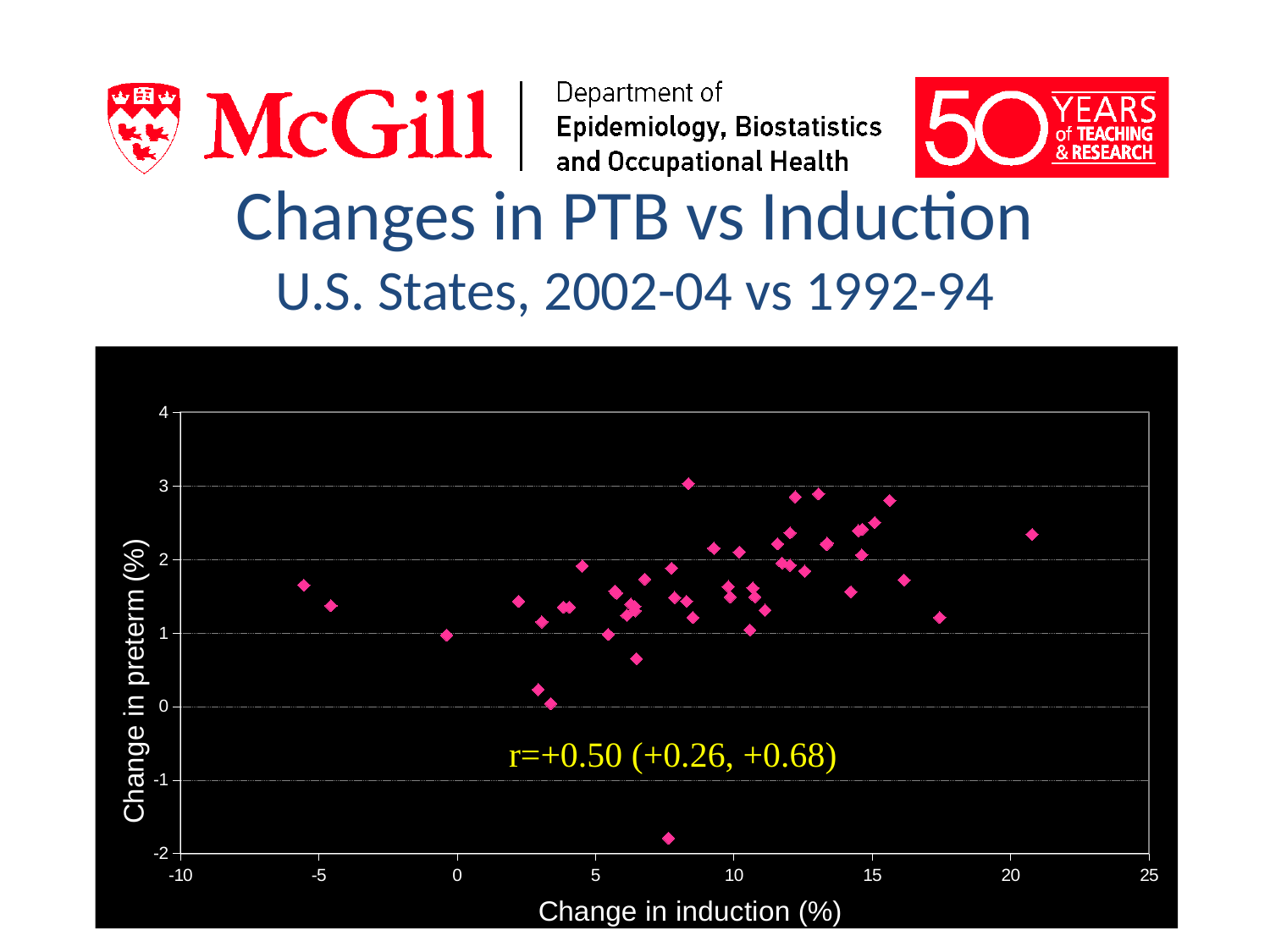
What is the highest tick value shown on the x axis? 25 What is the label of the x axis of the chart? Change in induction (%) What kind of chart is shown on the slide? Scatter plot Is the change in preterm for the lowest point on the chart greater or less than -1? less Is the change in induction for the rightmost point on the chart greater or less than 20? greater What correlation coefficient r is printed on the chart? +0.50 What is the label of the y axis of the chart? Change in preterm (%) What is the highest tick value shown on the y axis? 4 Is the change in induction for the leftmost point on the chart greater or less than -5? less Do the plotted points tend to rise or fall as change in induction increases along the x axis? Rise What interval is printed in parentheses after the correlation coefficient on the chart? (+0.26, +0.68) What is the lowest tick value shown on the x axis? -10